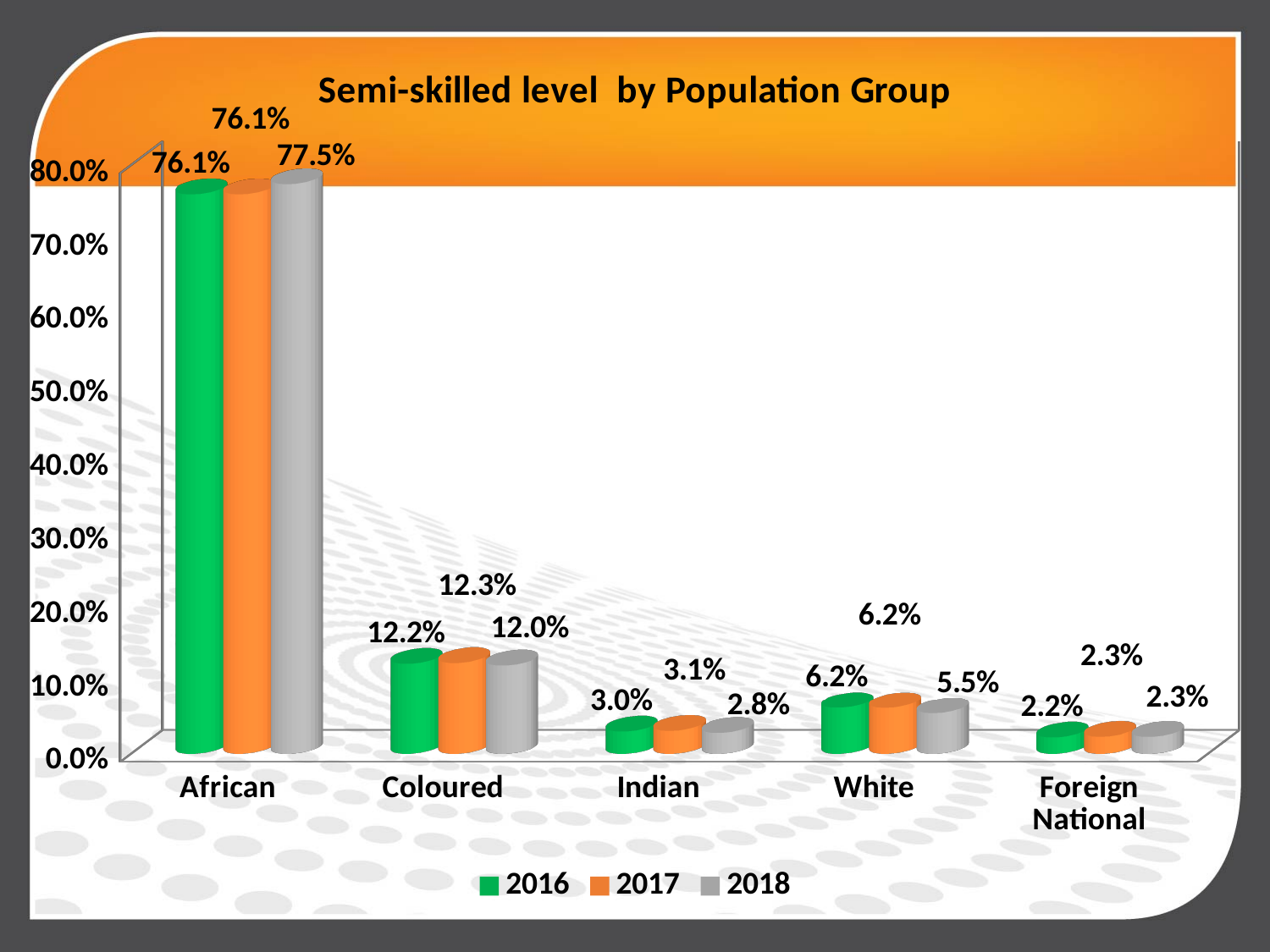
What kind of chart is shown on the slide? Bar chart What is the value for Coloured in 2017? 12.3% What is the value for White in 2018? 5.5% How many series does the legend list? 3 Which population group has the highest value in 2016? African How many population groups are shown on the x axis? 5 What is the value for African in 2018? 77.5% What is the value for Indian in 2018? 2.8% Which population group has the lowest value in 2018? Foreign National Which is larger, the 2016 value for White or the 2016 value for Indian? White What is the value for Foreign National in 2016? 2.2% What is the difference between the 2018 and 2016 values for African? 1.4%